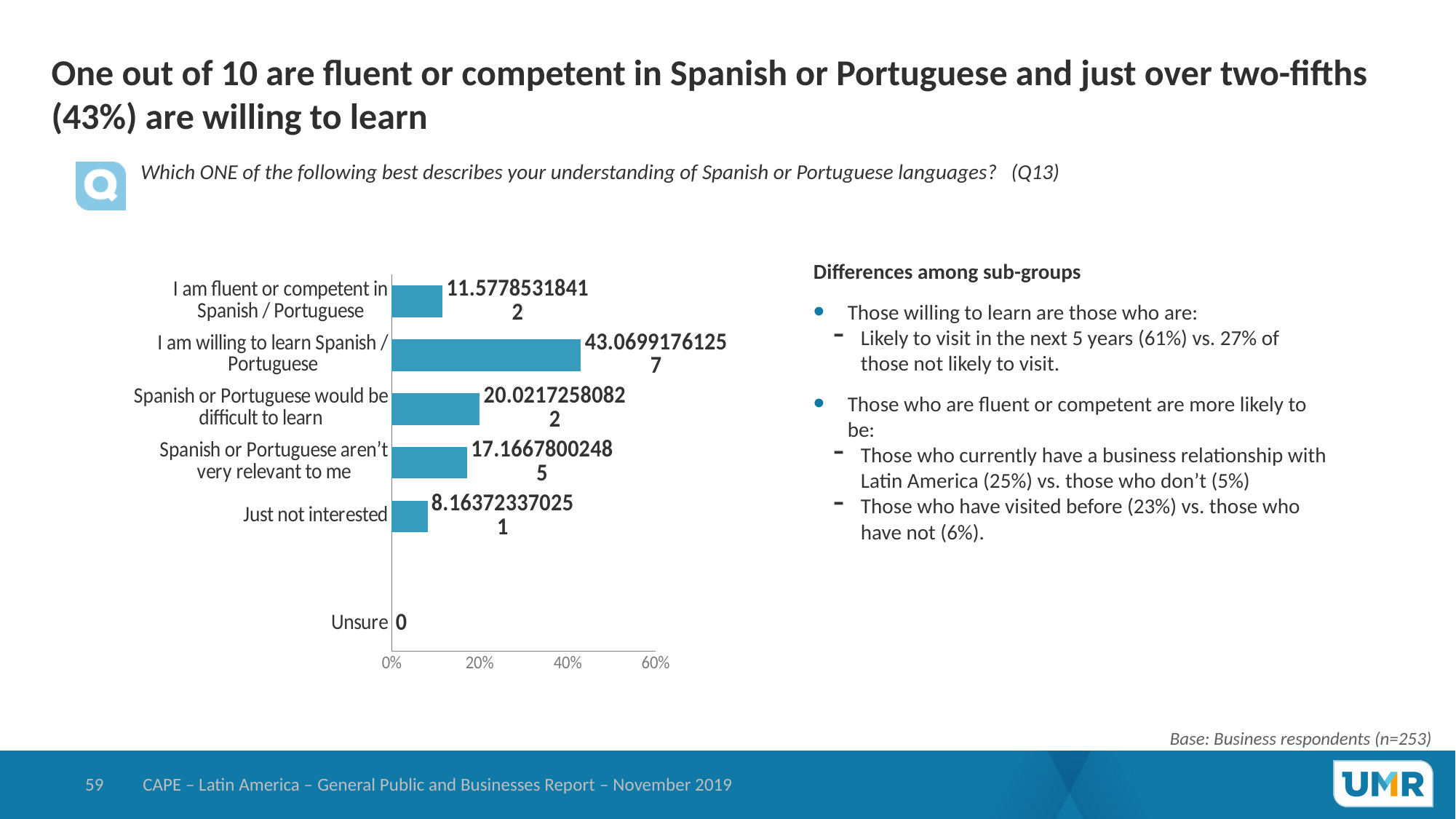
How many categories are shown in the chart? 6 Is the value for "I am willing to learn Spanish / Portuguese" greater or less than 40%? greater What is the value for "I am willing to learn Spanish / Portuguese"? 43.06991761257 What kind of chart is shown on the slide? bar chart What is the value for "Just not interested"? 8.163723370251 Is the value for "I am fluent or competent in Spanish / Portuguese" greater or less than 20%? less Which is larger: "Spanish or Portuguese would be difficult to learn" or "Spanish or Portuguese aren't very relevant to me"? Spanish or Portuguese would be difficult to learn What is the difference between the values for "I am willing to learn Spanish / Portuguese" and "I am fluent or competent in Spanish / Portuguese"? 31.49206442845 What is the value for "I am fluent or competent in Spanish / Portuguese"? 11.57785318412 What is the value for "Unsure"? 0 Which category has the lowest value? Unsure Which category has the highest value? I am willing to learn Spanish / Portuguese